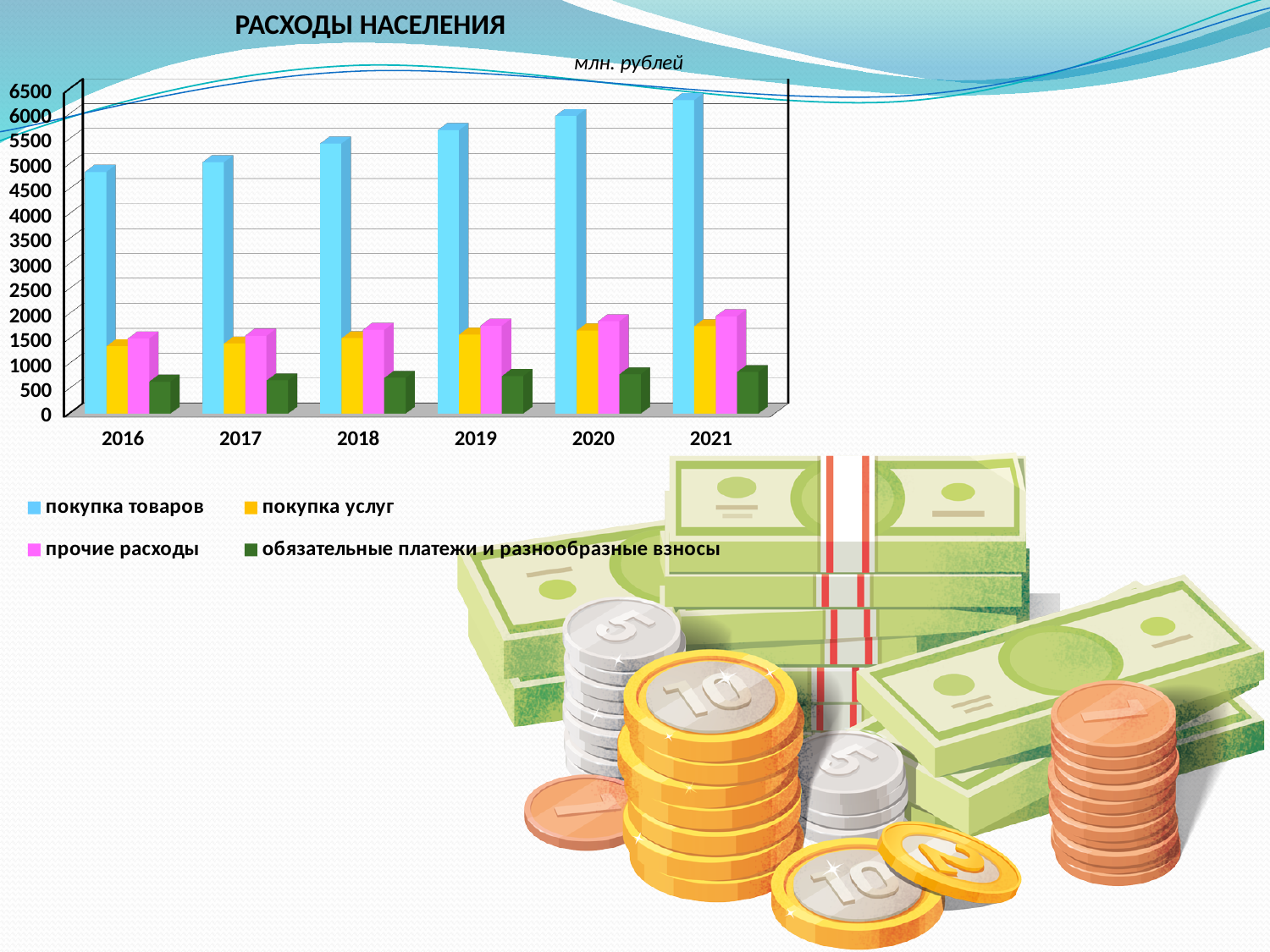
How many years are shown on the x axis? 6 In which year is the value for покупка товаров the highest? 2021 Which is larger in 2021: прочие расходы or покупка услуг? прочие расходы Do the values for покупка товаров rise or fall from 2016 to 2021? rise What unit is indicated for the values on the chart? млн. рублей Is the value for покупка товаров in 2021 greater or less than 5500? greater How many series does the legend list? 4 Which is larger in 2019: покупка услуг or обязательные платежи и разнообразные взносы? покупка услуг Is the value for обязательные платежи и разнообразные взносы in 2016 greater or less than 1000? less What is the title of the chart? РАСХОДЫ НАСЕЛЕНИЯ What kind of chart is shown on the slide? bar chart Is the value for покупка товаров in 2016 greater or less than 4500? greater